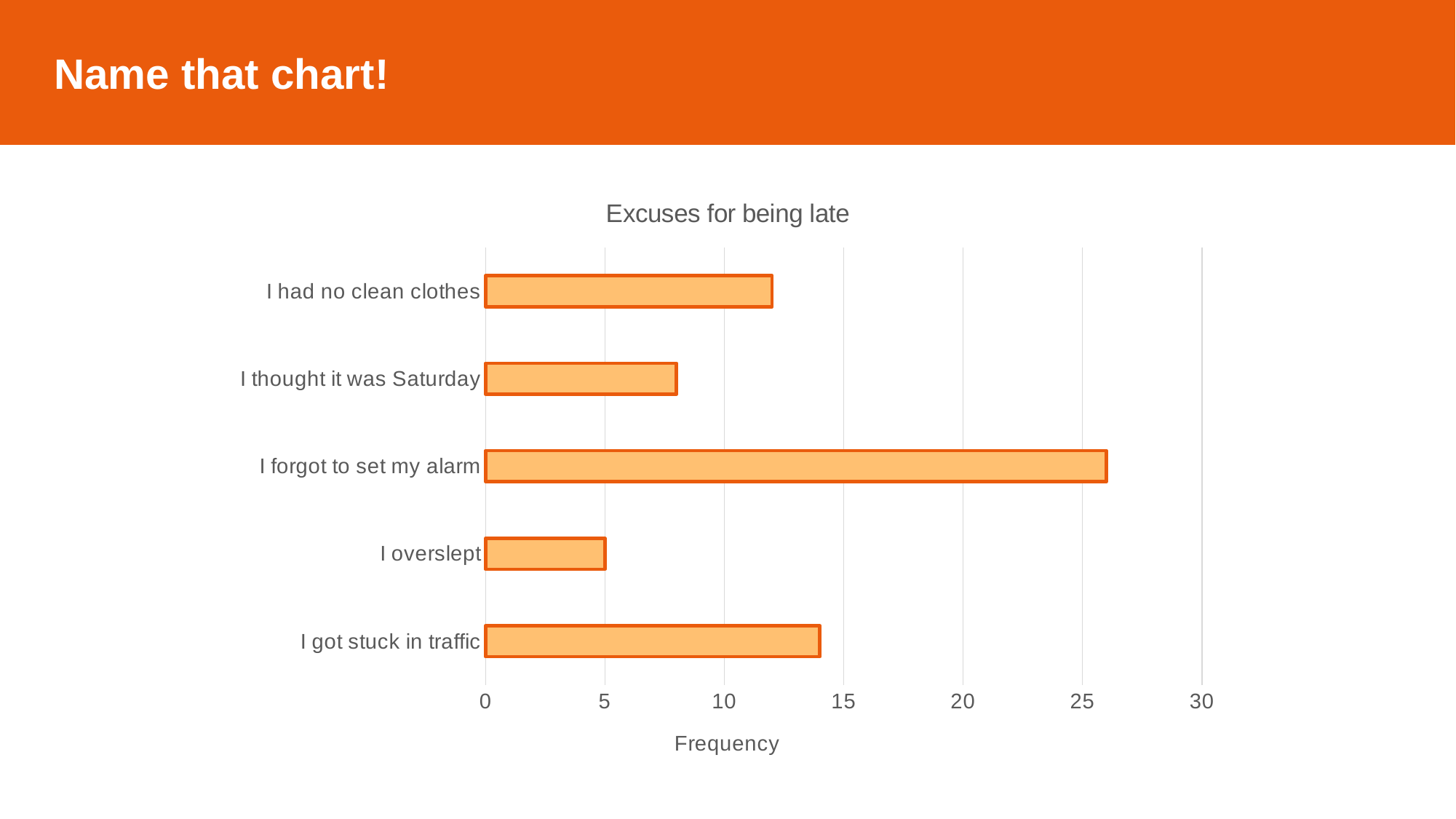
Is the frequency for "I got stuck in traffic" greater or less than 15? less Which has a higher frequency, "I thought it was Saturday" or "I got stuck in traffic"? I got stuck in traffic Which excuse has the lowest frequency? I overslept Is the frequency for "I had no clean clothes" greater or less than 10? greater Is the frequency for "I forgot to set my alarm" greater or less than 25? greater Which excuse has the highest frequency? I forgot to set my alarm What is the title of the chart? Excuses for being late What is the frequency for "I overslept"? 5 How many excuses (categories) are plotted in the chart? 5 What is the label on the horizontal axis of the chart? Frequency What kind of chart is shown on the slide? bar chart